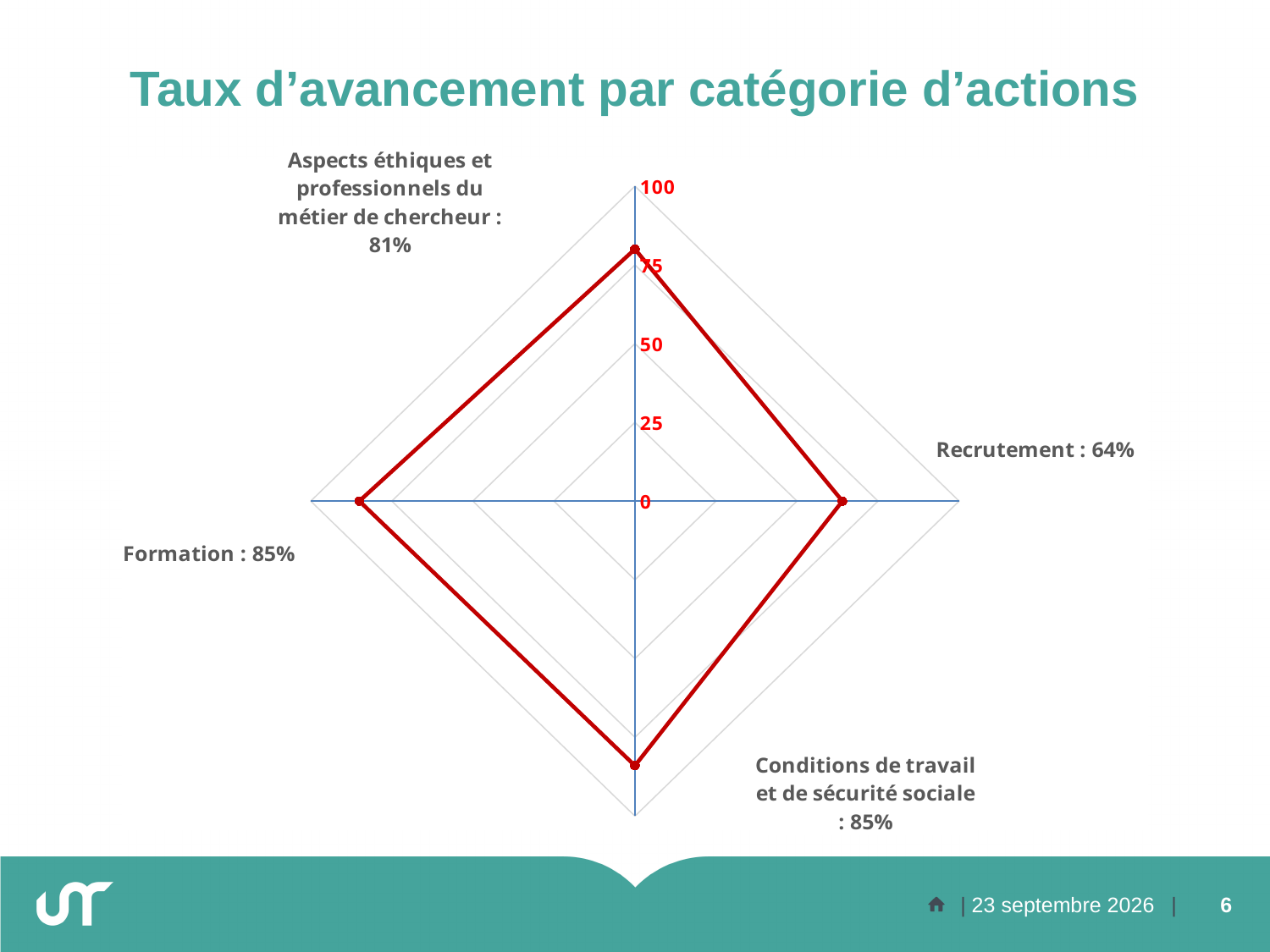
What is the value for Conditions de travail et de sécurité sociale? 85% How many categories does the chart show? 4 What kind of chart is shown on the slide? Radar chart Which category has the lowest value? Recrutement Which is larger, the value for Aspects éthiques et professionnels du métier de chercheur or the value for Recrutement? Aspects éthiques et professionnels du métier de chercheur What is the value for Formation? 85% What is the value for Aspects éthiques et professionnels du métier de chercheur? 81% What is the value for Recrutement? 64% What is the difference between the values for Conditions de travail et de sécurité sociale and Aspects éthiques et professionnels du métier de chercheur? 4 percentage points What is the title of the slide? Taux d'avancement par catégorie d'actions Is the value for Recrutement greater or less than 75? less What is the difference between the values for Formation and Recrutement? 21 percentage points